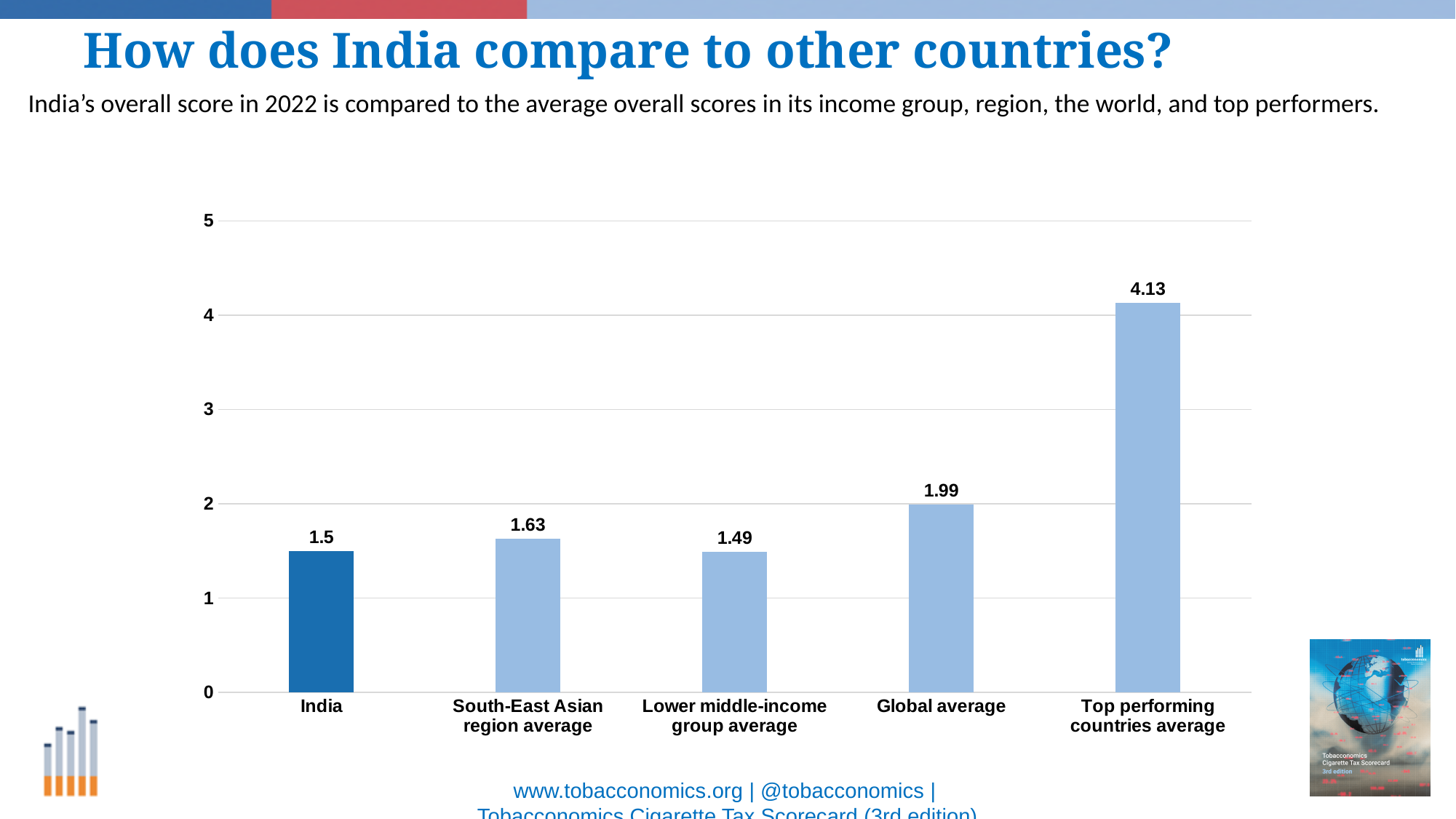
Is the value for the Top performing countries average greater or less than 4? greater What is the value shown for India? 1.5 What is the value shown for the Lower middle-income group average? 1.49 Which category has the highest value? Top performing countries average What kind of chart is shown on the slide? Bar chart What is the value shown for the Global average? 1.99 What is the difference between the Top performing countries average and India? 2.63 How many categories are shown in the chart? 5 What is the value shown for the Top performing countries average? 4.13 Which is larger, the Global average or the South-East Asian region average? Global average Which category has the lowest value? Lower middle-income group average What is the difference between the Global average and the South-East Asian region average? 0.36